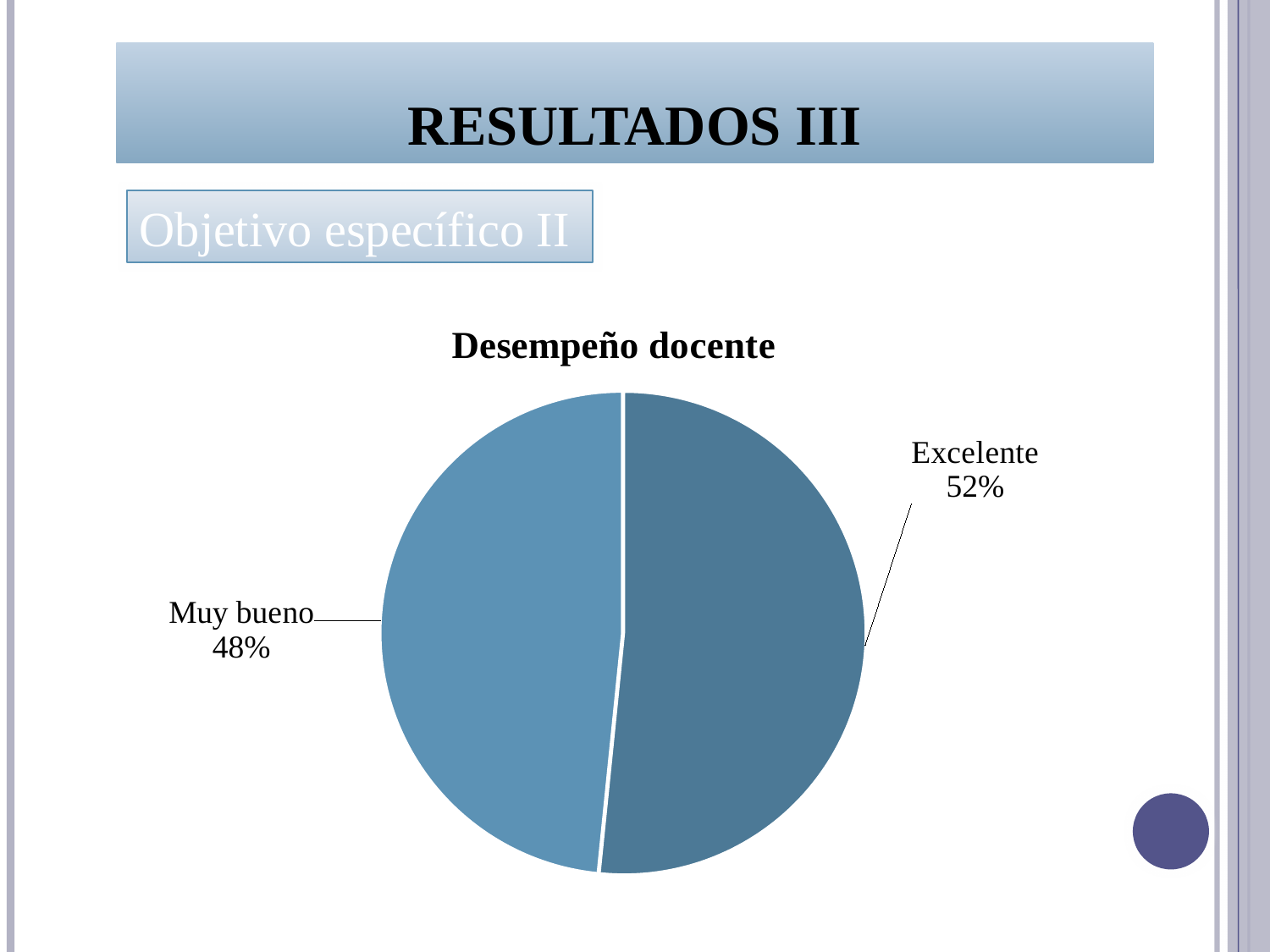
Is the share for Excelente greater or less than 50%? greater Which is larger, the share for Excelente or the share for Muy bueno? Excelente What is the title of the chart? Desempeño docente What kind of chart is shown on the slide? pie chart Which category has the largest share of the pie? Excelente What percentage of the pie is labelled Excelente? 52% Is the share for Muy bueno greater or less than 50%? less What percentage of the pie is labelled Muy bueno? 48% How many slices does the pie chart have? 2 What is the combined share of Excelente and Muy bueno? 100% What is the difference in percentage points between Excelente and Muy bueno? 4 Which category has the smallest share of the pie? Muy bueno